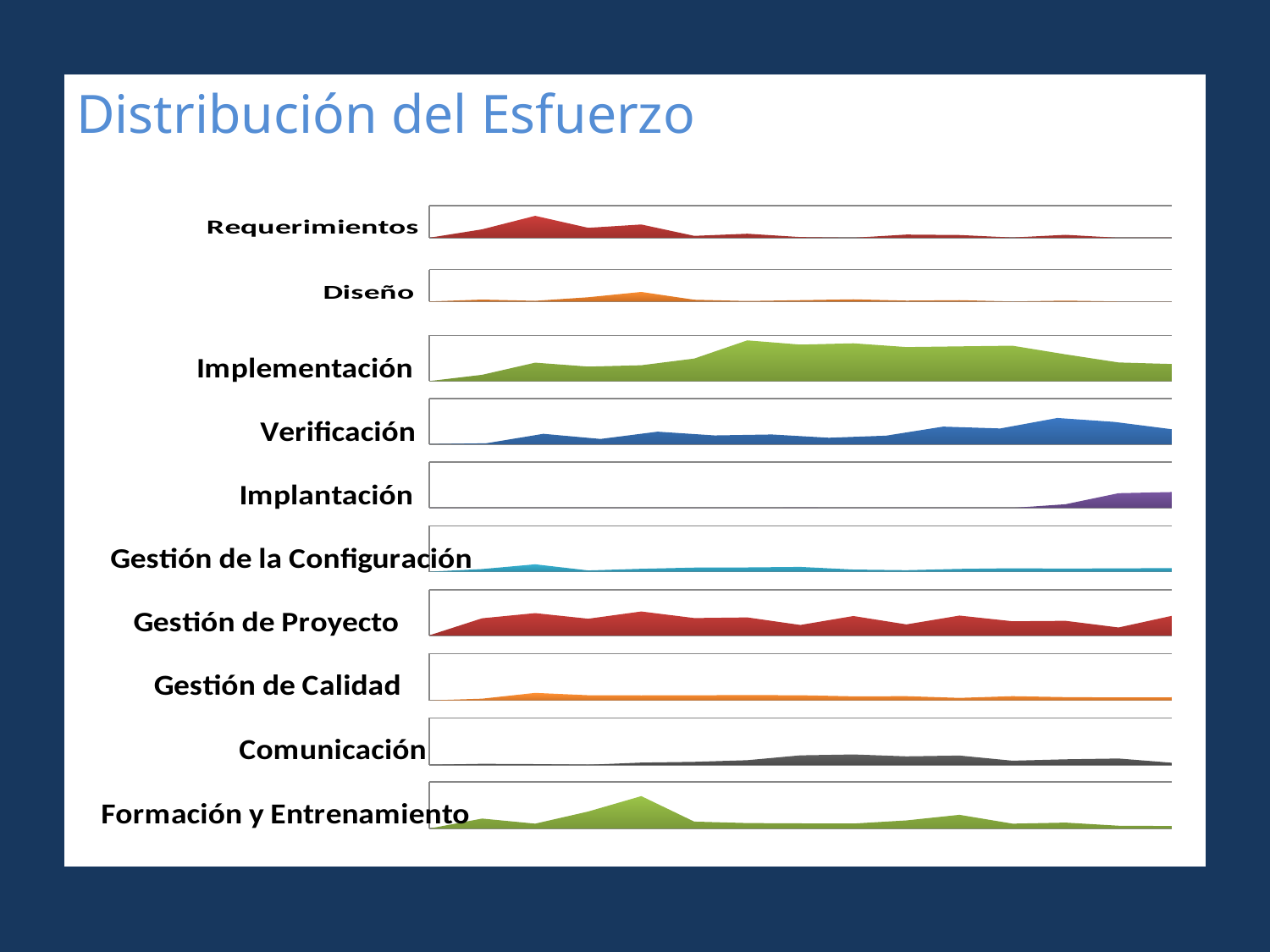
In the Formación y Entrenamiento chart, after the early peak, do the values rise or fall along the x axis? fall What kind of chart is used for each row on the slide? area chart Which row chart is labelled 'Comunicación' — what colour is its area? dark gray In the Implantación chart, do the values rise or fall toward the right end of the x axis? rise In the Verificación chart, do the values generally rise or fall along the x axis? rise What is the title of the slide containing the charts? Distribución del Esfuerzo What colour is the area in the Implantación chart? purple How many separate row charts are shown on the slide? 10